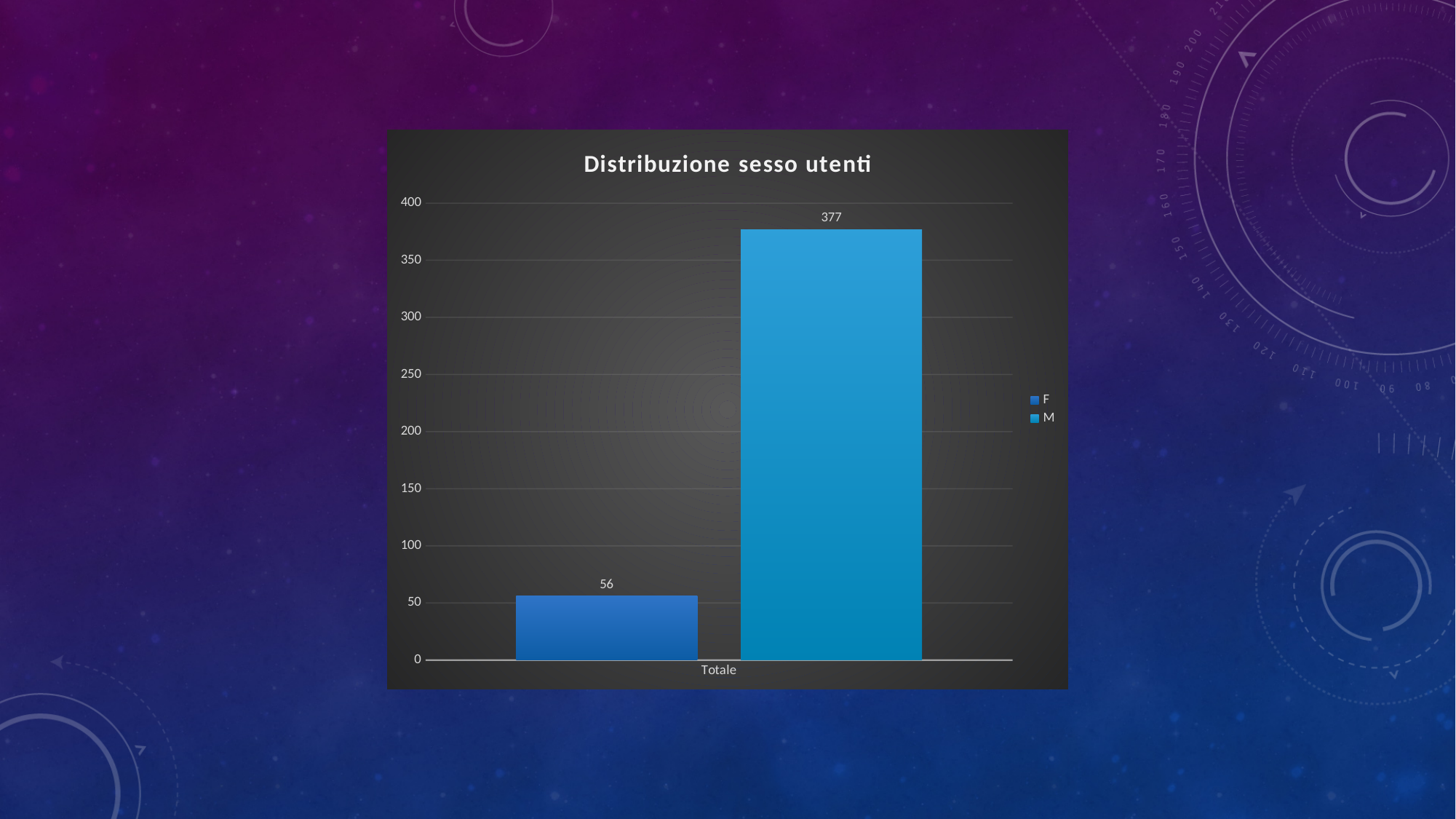
Which series has the highest value? M What is the value for F in the chart? 56 Which is larger, the value for F or the value for M? M What is the category label on the x axis? Totale What is the difference between the values for M and F? 321 What is the title of the chart? Distribuzione sesso utenti What is the value for M in the chart? 377 What kind of chart is shown on the slide? Bar chart Is the value for F greater or less than 100? less Which series has the lowest value? F How many series does the legend list? 2 Is the value for M greater or less than 350? greater